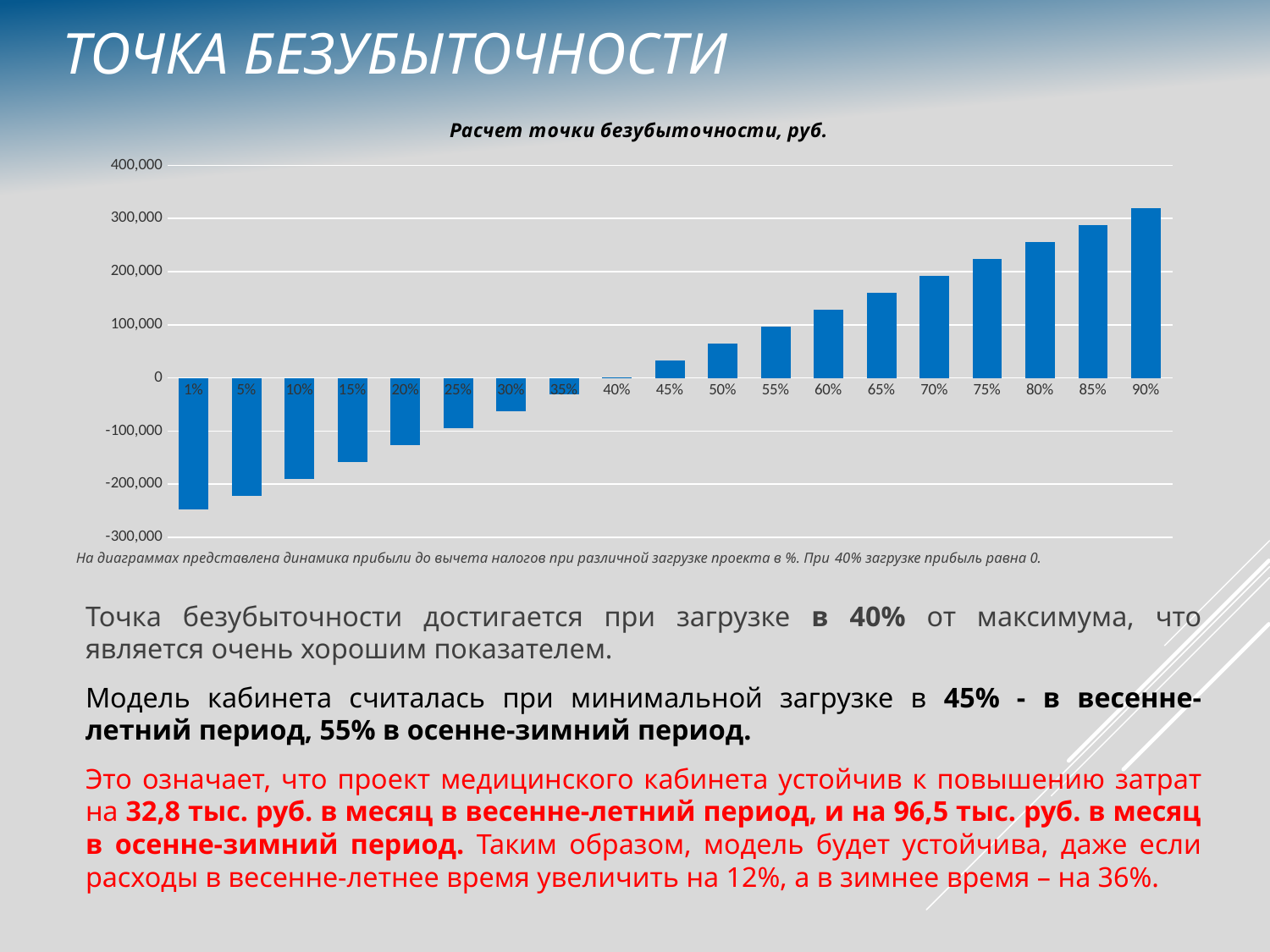
Which load percentage has the lowest value on the chart? 1% Which has the larger value, 80% or 60%? 80% Do the values rise or fall as the load percentage increases along the x axis? rise What is the title of the chart? Расчет точки безубыточности, руб. Is the value for 1% greater or less than -200,000? less How many load-percentage categories are plotted on the x axis? 19 Is the value for 50% greater or less than 100,000? less What kind of chart is shown on the slide? bar chart Is the value for 60% greater or less than 100,000? greater Which load percentage has the highest value on the chart? 90%